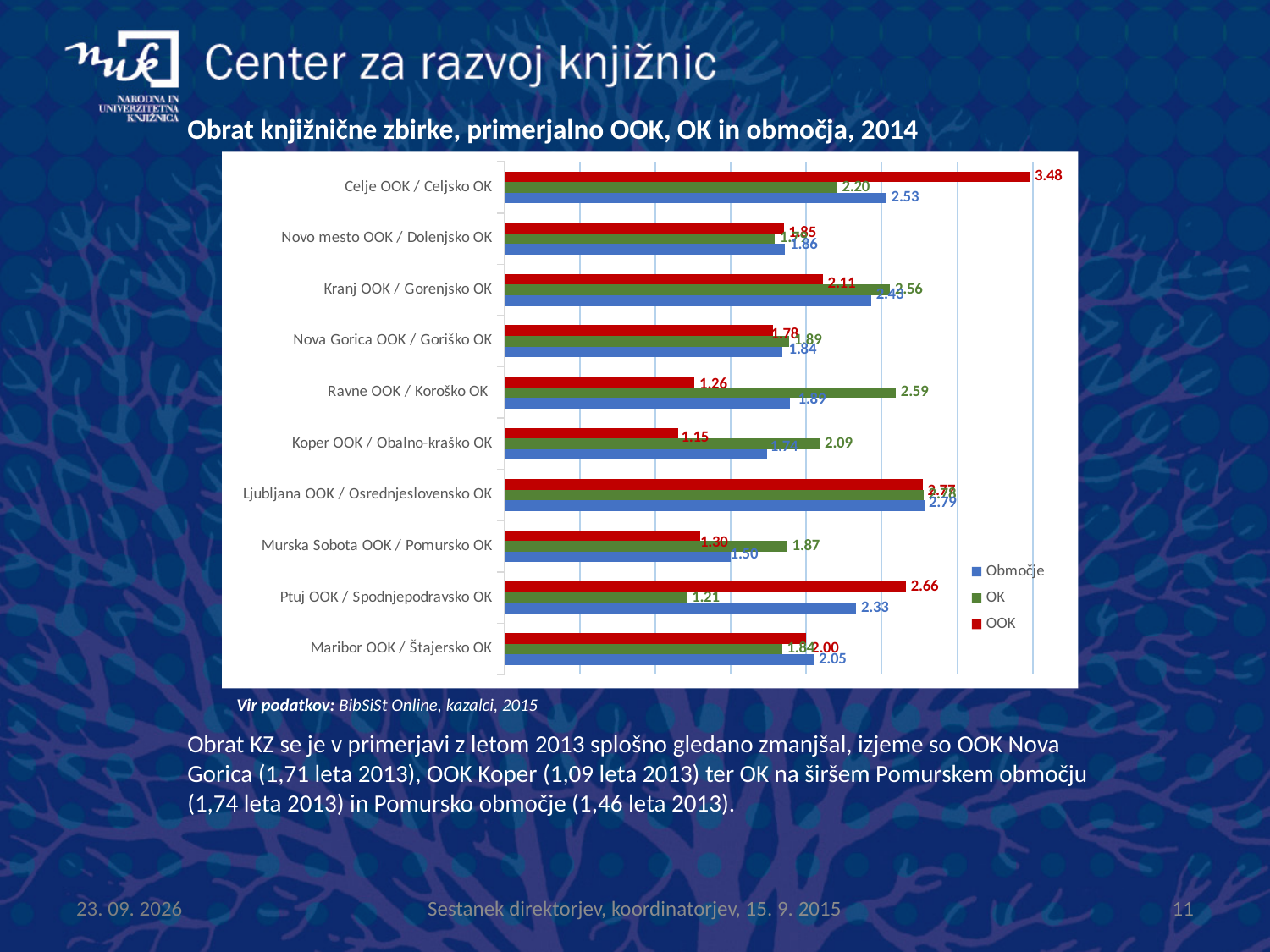
How many series does the legend list? 3 For Ptuj OOK / Spodnjepodravsko OK, which is larger: the OOK value or the OK value? OOK Which category has the lowest OOK value? Koper OOK / Obalno-kraško OK What is the difference between the OOK value and the OK value for Celje OOK / Celjsko OK? 1.28 Which series is shown in red in the legend? OOK What is the OK value for Ravne OOK / Koroško OK? 2.59 What is the OOK value for Celje OOK / Celjsko OK? 3.48 Which category has the highest OOK value? Celje OOK / Celjsko OK What is the Območje value for Ptuj OOK / Spodnjepodravsko OK? 2.33 How many categories (OOK / OK pairs) are shown on the chart? 10 What kind of chart is shown on the slide? bar chart What is the difference between the OOK value and the Območje value for Ravne OOK / Koroško OK? 0.63